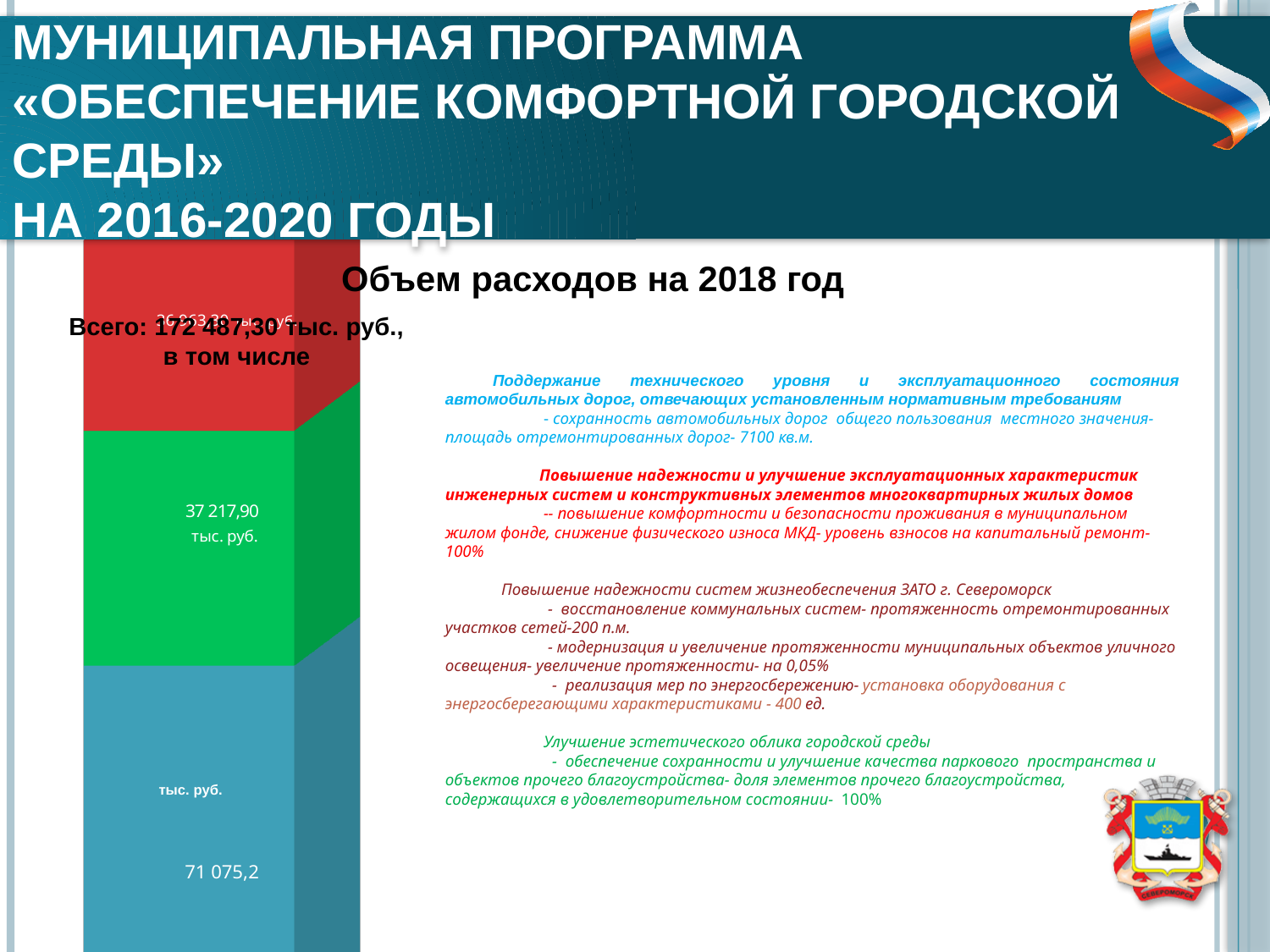
Is the value of the green segment greater or less than 50 000? less What value is printed on the green segment of the stacked bar? 37 217,90 тыс. руб. What is the difference between the bottom blue segment (71 075,2) and the green segment (37 217,90)? 33 857,3 What value is printed on the bottom (blue) segment of the stacked bar? 71 075,2 What kind of chart is shown on the left of the slide? bar chart Is the value of the bottom blue segment greater or less than 50 000? greater What total amount of expenditures for 2018 is stated next to the chart? 172 487,30 тыс. руб. What is the heading above the chart describing the expenditures? Объем расходов на 2018 год Which segment has the larger value: the green segment or the bottom blue segment? the bottom blue segment